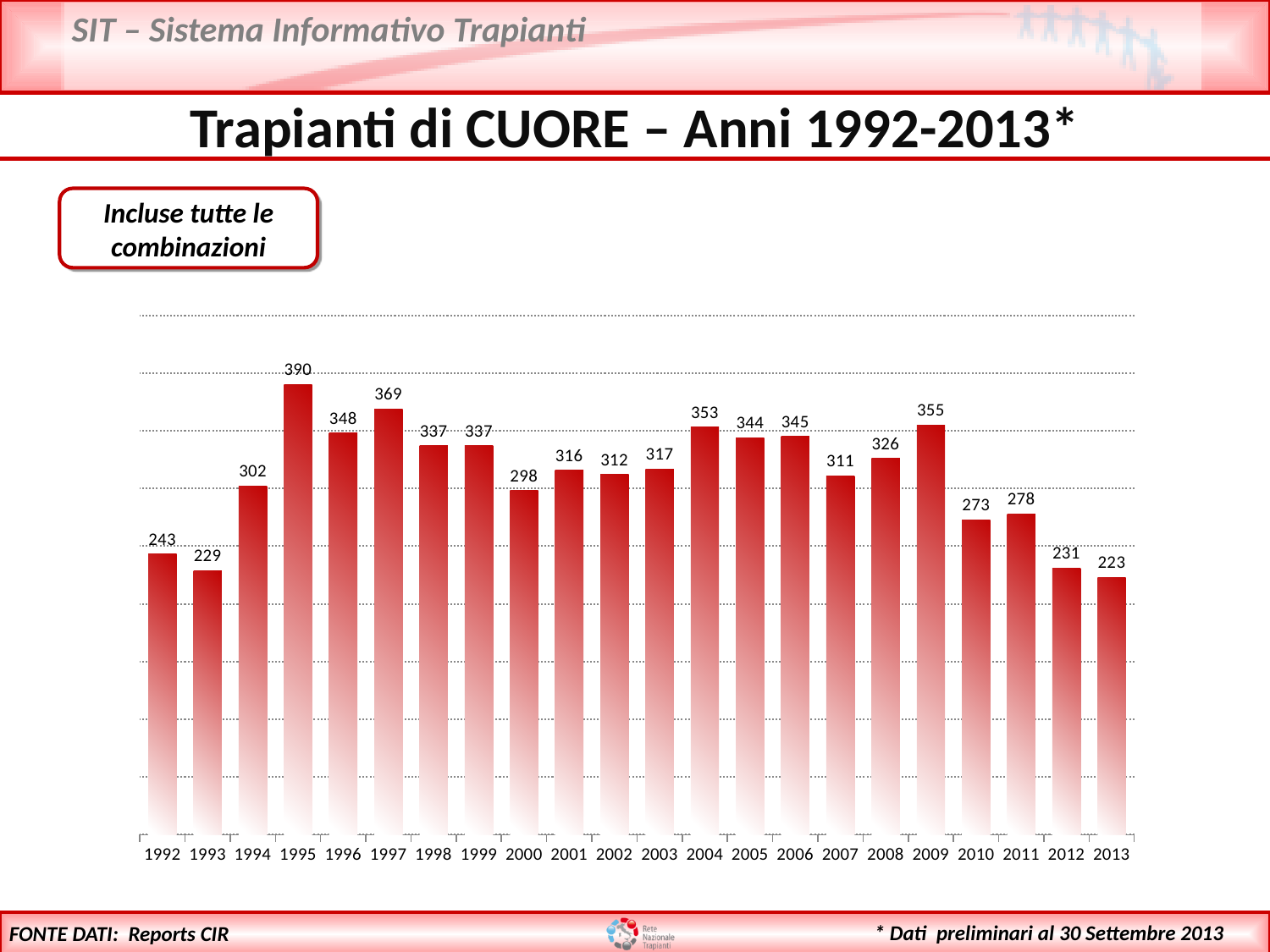
What is the value for 2004? 353 What is the difference between the values for 1995 and 1992? 147 Which year has the highest value? 1995 What is the difference between the values for 2009 and 2010? 82 Do the values rise or fall from 2009 to 2013? fall What is the title of the chart? Trapianti di CUORE – Anni 1992-2013* What kind of chart is shown on the slide? bar chart Which year has the lowest value? 2013 What is the value for 1995? 390 How many years are shown on the x axis? 22 What is the value for 2013? 223 Which is larger, the value for 1997 or the value for 2009? 1997